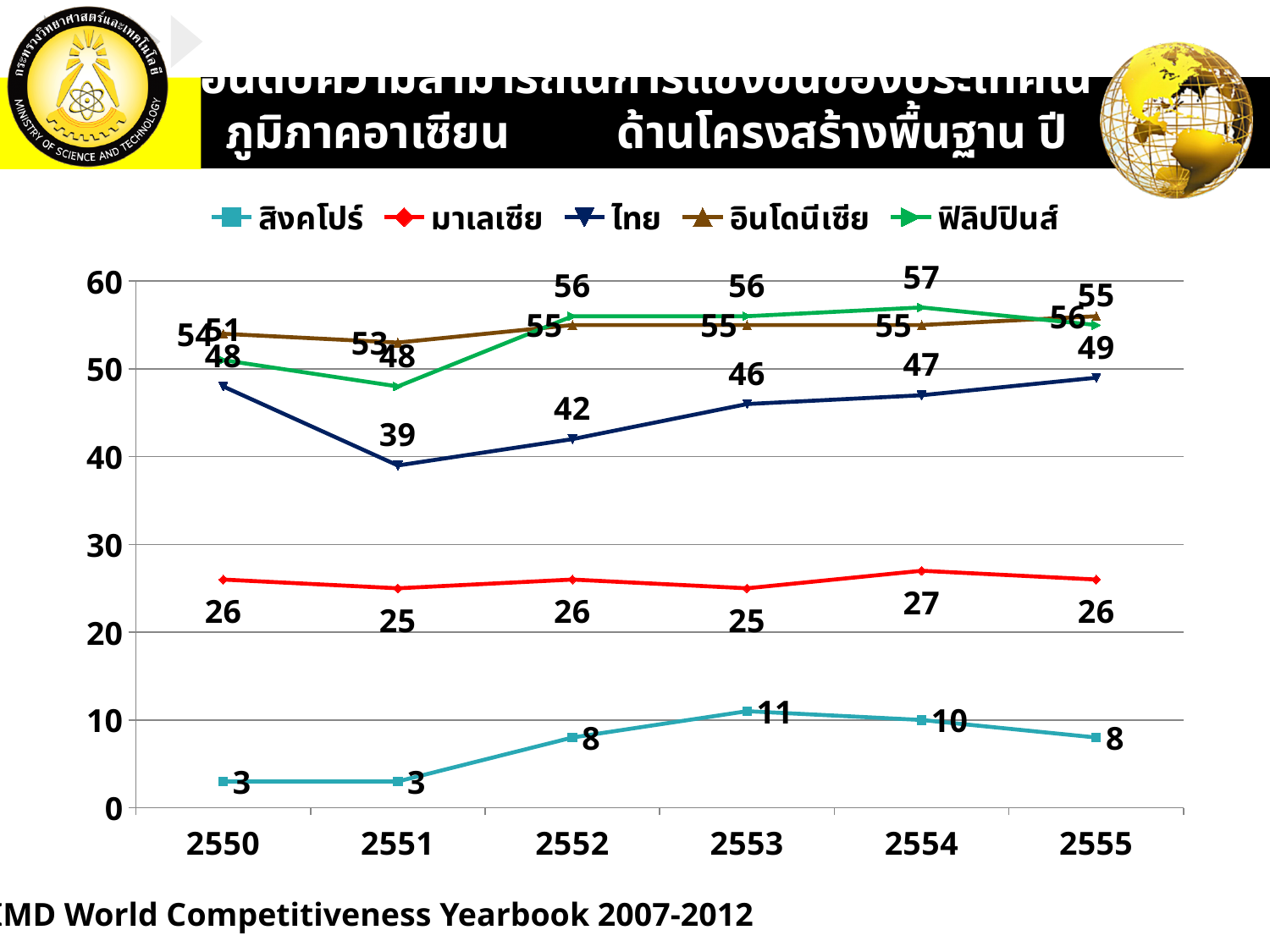
What is the value for ฟิลิปปินส์ in 2554? 57 In 2552, which is larger: the value for ไทย or the value for มาเลเซีย? ไทย In which year does สิงคโปร์ reach its highest value? 2553 What is the value for มาเลเซีย in 2554? 27 How many series does the legend list? 5 What is the difference between the value for ไทย in 2555 and in 2551? 10 What is the value for ไทย in 2551? 39 In which year does ไทย have its lowest value? 2551 What kind of chart is shown on the slide? line chart Is the value for มาเลเซีย in 2550 greater or less than 30? less How many years are shown on the x axis? 6 What is the value for สิงคโปร์ in 2553? 11